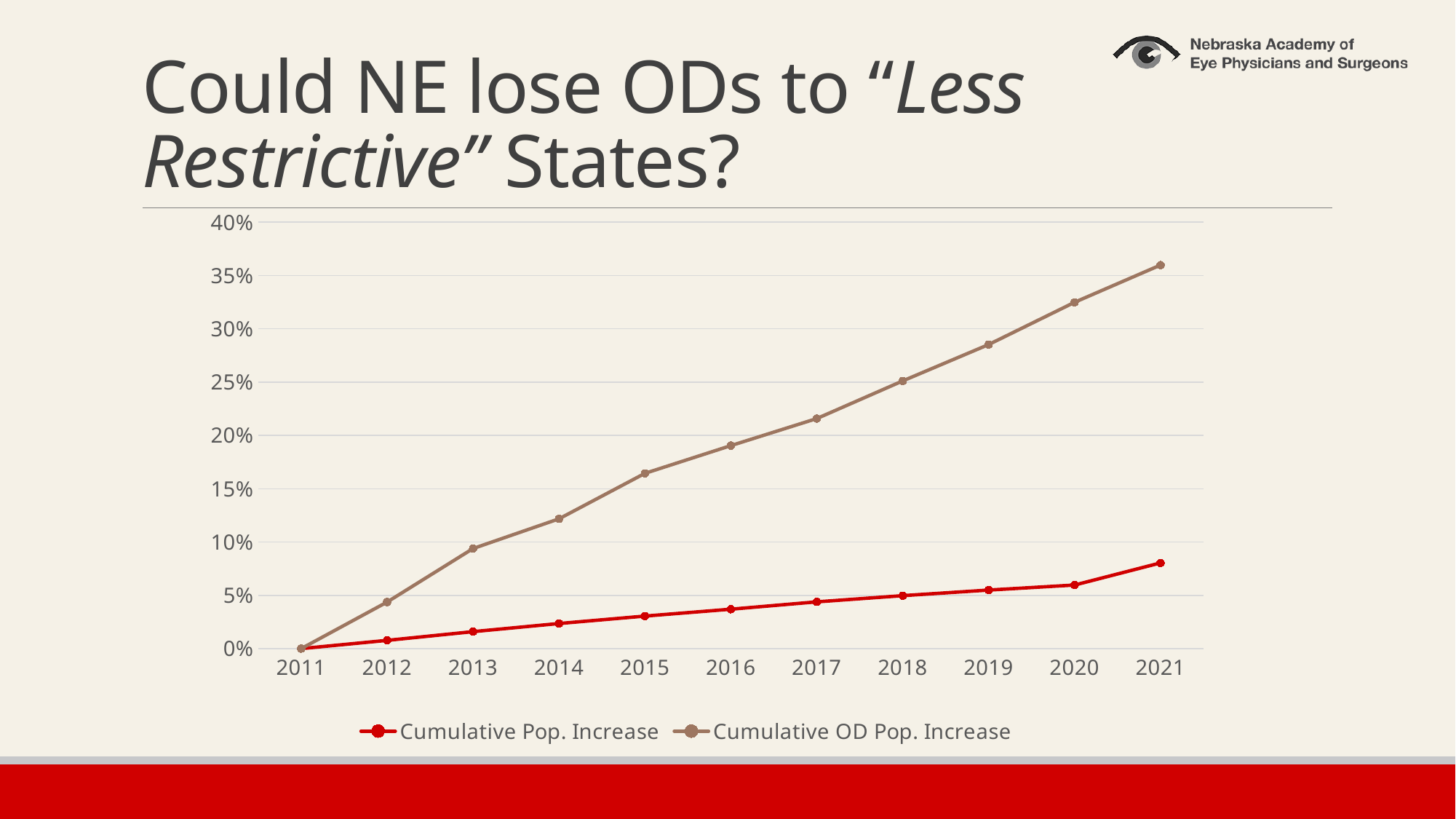
Is the value for Cumulative OD Pop. Increase in 2016 greater or less than 15%? greater In which year is Cumulative OD Pop. Increase highest? 2021 What colour is the Cumulative Pop. Increase line? Red Does the Cumulative OD Pop. Increase line rise or fall from 2011 to 2021? Rise What kind of chart is shown on the slide? Line chart How many years are plotted along the x axis? 11 In which year is Cumulative Pop. Increase lowest? 2011 In 2021, which series has the higher value, Cumulative Pop. Increase or Cumulative OD Pop. Increase? Cumulative OD Pop. Increase Is the value for Cumulative Pop. Increase in 2021 greater or less than 10%? less How many series does the legend list? 2 Is the value for Cumulative OD Pop. Increase in 2021 greater or less than 30%? greater What is the value of Cumulative OD Pop. Increase in 2011? 0%